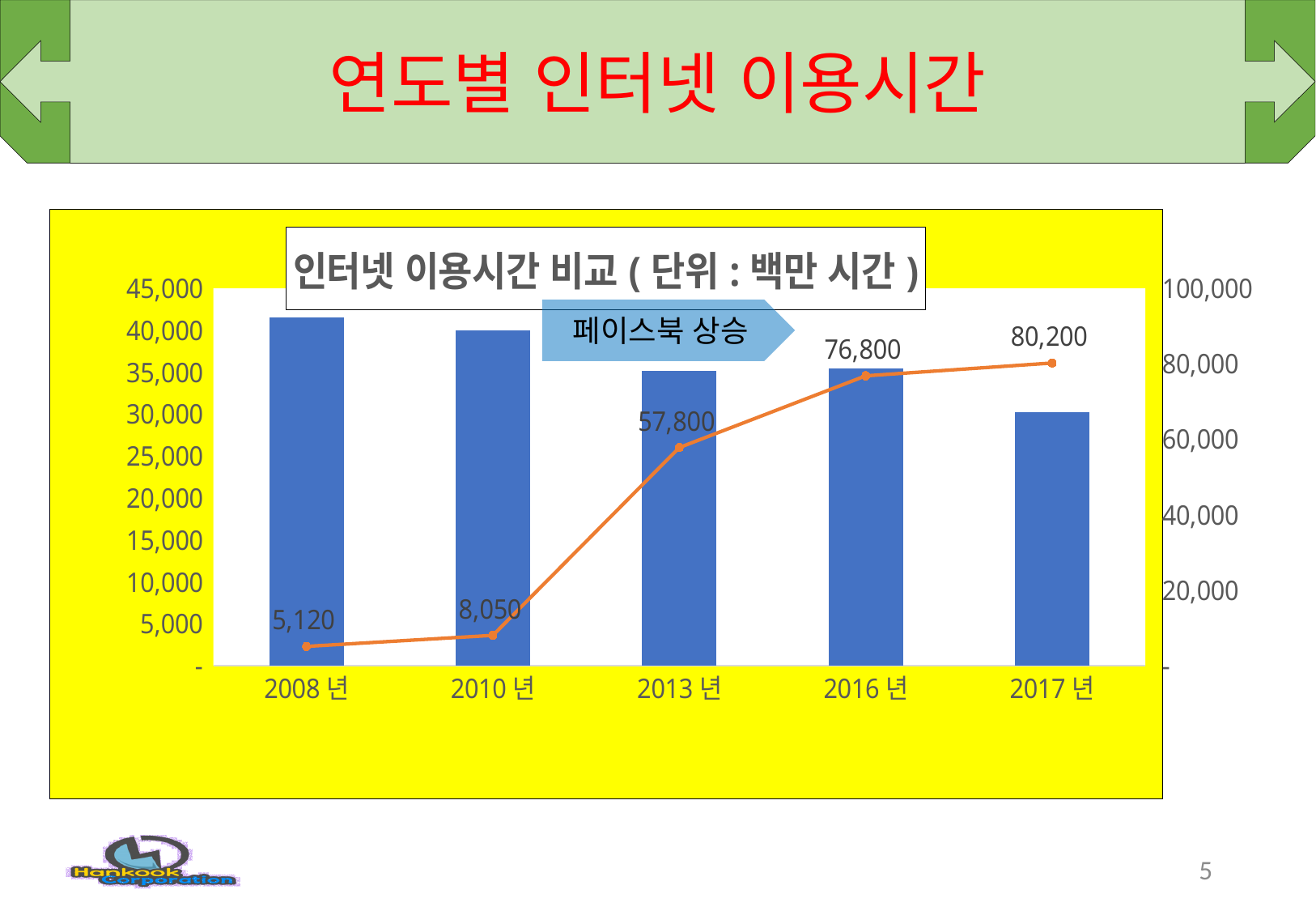
Which year has the larger orange line value, 2010 년 or 2013 년? 2013 년 Which year has the shortest blue bar? 2017 년 What is the value of the orange line for 2013 년? 57,800 What is the value of the orange line for 2017 년? 80,200 Do the values of the orange line rise or fall from 2008 년 to 2017 년? rise What is the difference between the orange line values for 2017 년 and 2016 년? 3,400 Which year has the lowest value on the orange line? 2008 년 What is the difference between the orange line values for 2013 년 and 2010 년? 49,750 How many years are shown on the x axis? 5 Is the blue bar for 2017 년 greater or less than 35,000 on the left axis? less Which year has the highest value on the orange line? 2017 년 What is the value of the orange line for 2008 년? 5,120